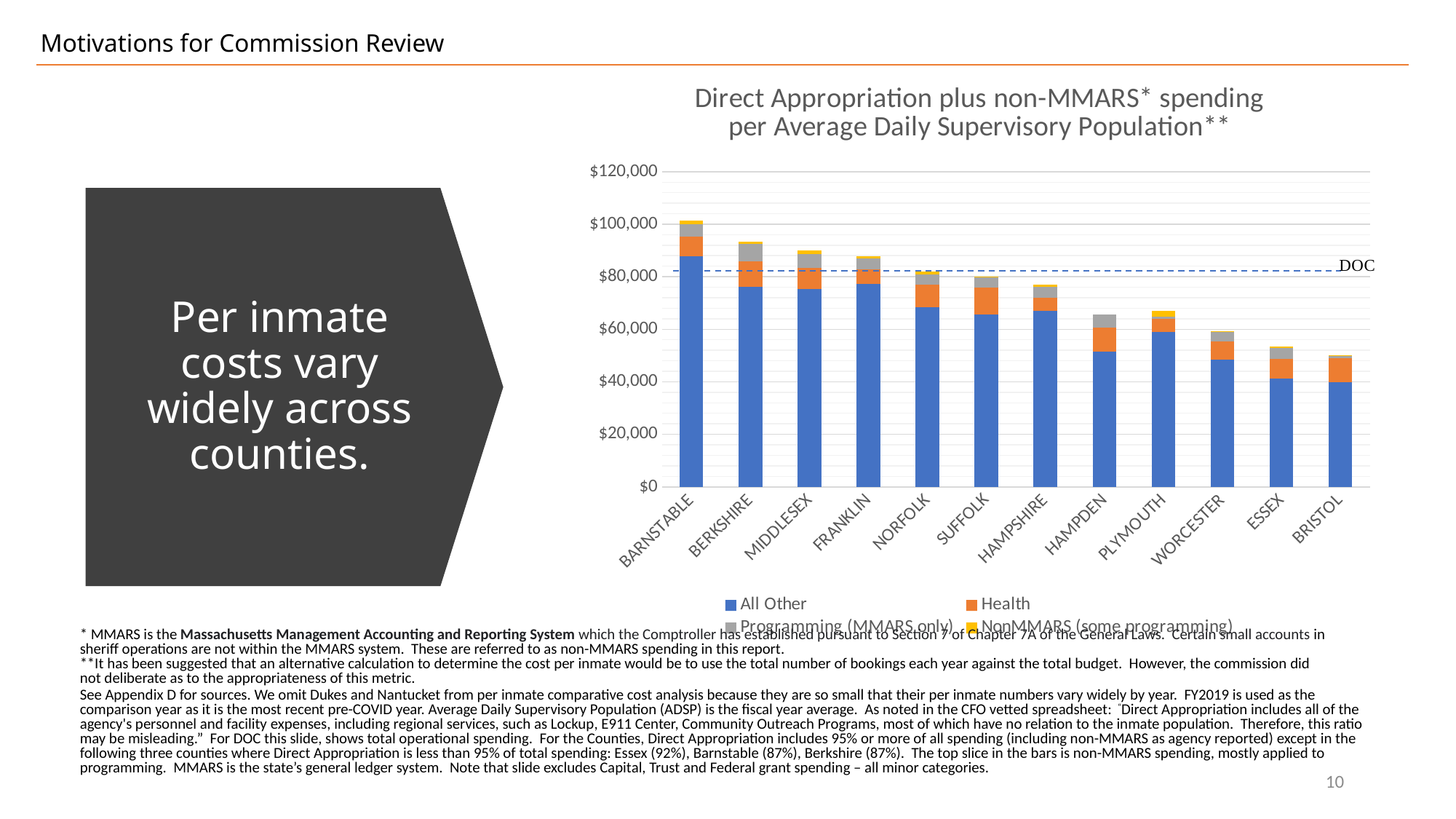
Which county has the lowest total spending per Average Daily Supervisory Population? Bristol How many series does the chart's legend list? 4 Is the total value for Barnstable greater or less than $80,000? greater Is the total value for Bristol greater or less than $60,000? less Which county has a larger total bar, Berkshire or Hampden? Berkshire Which county has the highest total spending per Average Daily Supervisory Population? Barnstable What label is attached to the dashed horizontal reference line on the chart? DOC Is the total value for Berkshire greater or less than $80,000? greater Do the total bar values rise or fall moving from left to right along the x axis? Fall What kind of chart is shown on the slide? Stacked bar chart How many counties are shown on the x axis of the chart? 12